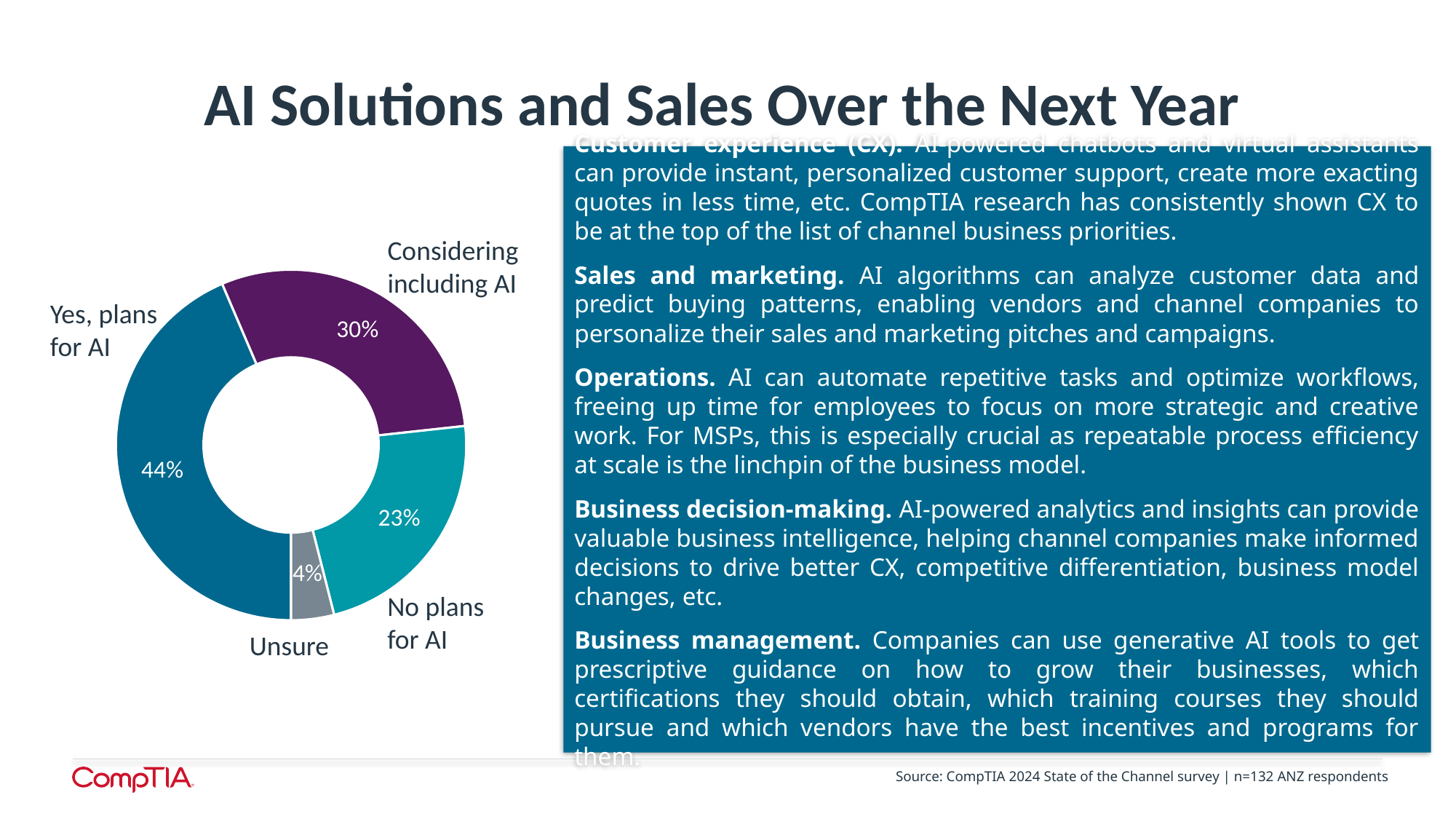
Which category has the largest share of the chart? Yes, plans for AI What percentage of respondents are 'Unsure'? 4% What percentage of respondents said 'Yes, plans for AI'? 44% What percentage of respondents are 'Considering including AI'? 30% What colour is the 'Unsure' slice of the chart? Grey How many categories are shown in the chart? 4 Which is larger: the share for 'Considering including AI' or the share for 'No plans for AI'? Considering including AI Which category has the smallest share of the chart? Unsure What is the combined share of 'Yes, plans for AI' and 'Considering including AI'? 74% What percentage of respondents have 'No plans for AI'? 23% What kind of chart is shown on the slide? Doughnut (pie) chart What is the difference in percentage points between 'Yes, plans for AI' and 'No plans for AI'? 21